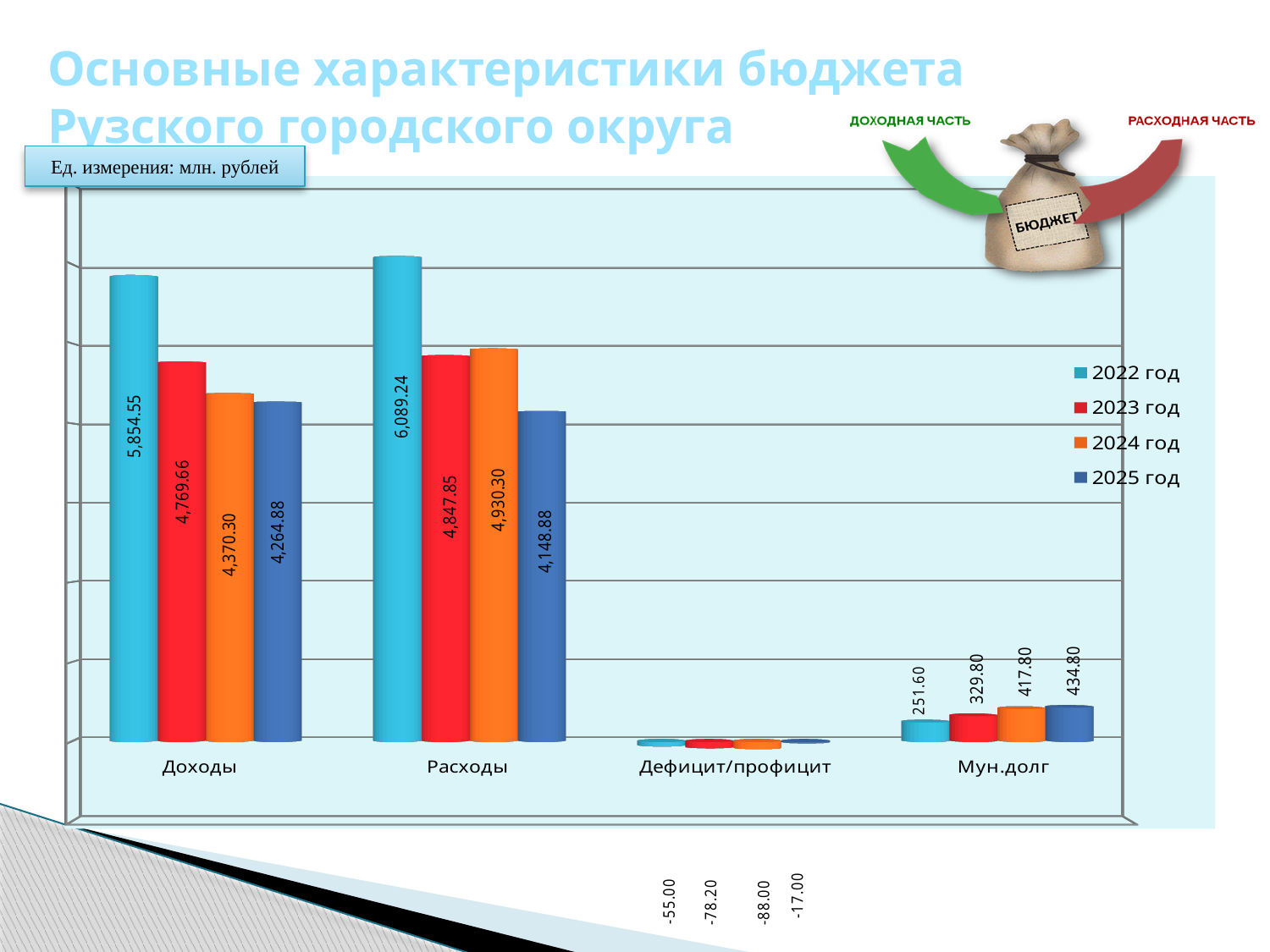
Which year has the highest value for Расходы? 2022 год What kind of chart is shown on the slide? Bar chart How many categories are shown on the x axis? 4 What is the value for Доходы in 2022 год? 5,854.55 What is the difference between Расходы and Доходы in 2025 год? 116.00 Which year has the lowest value for Мун.долг? 2022 год How many series does the legend list? 4 Do the values for Мун.долг rise or fall from 2022 год to 2025 год? Rise What is the value for Дефицит/профицит in 2023 год? -78.20 Which is larger for 2024 год: Доходы or Расходы? Расходы What is the value for Расходы in 2024 год? 4,930.30 What is the value for Мун.долг in 2025 год? 434.80